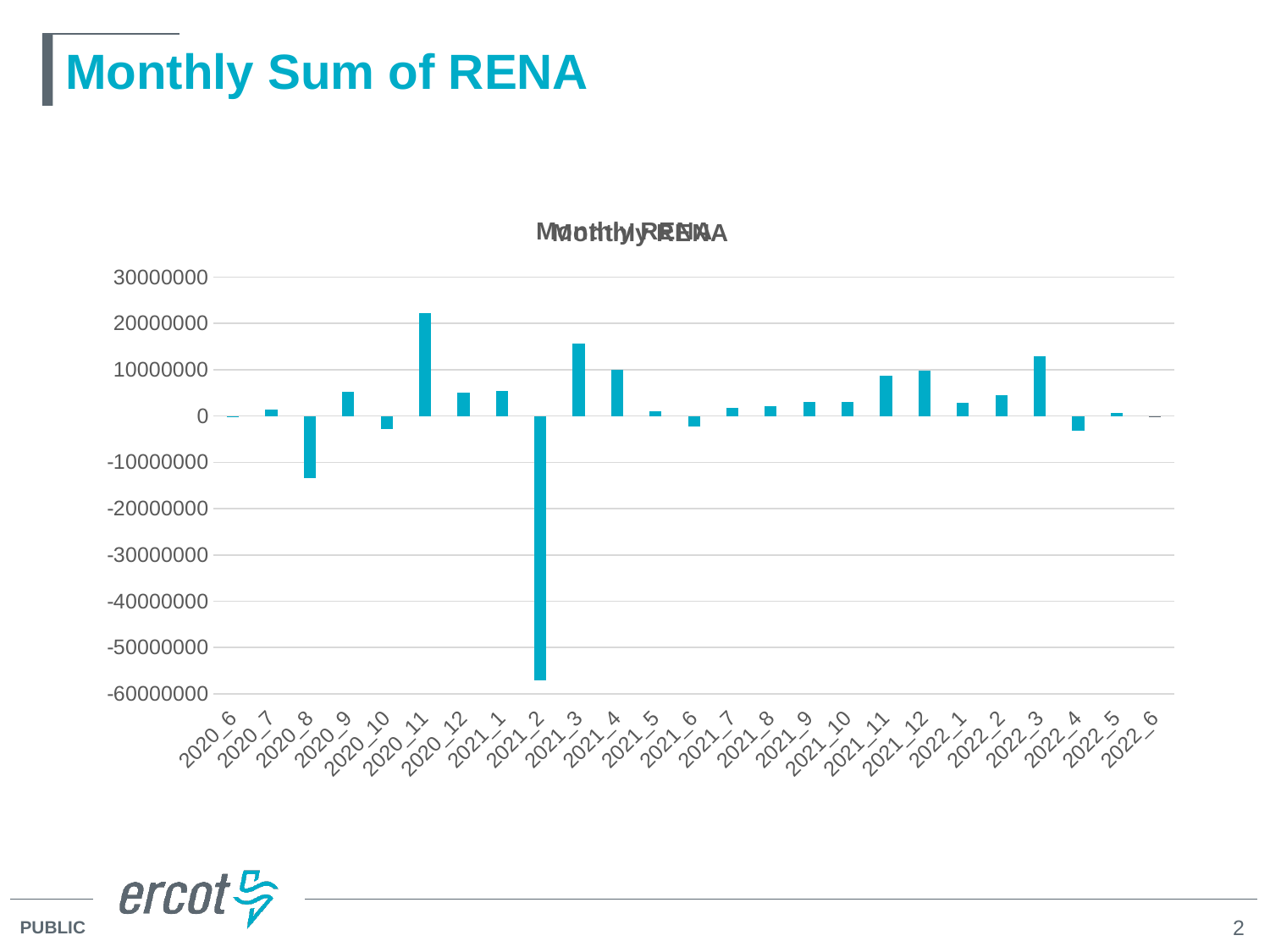
Which month has the lowest value? 2021_2 What kind of chart is shown on the slide? bar chart Is the value for 2021_2 greater or less than -50000000? less Is the value for 2020_8 greater or less than -10000000? less Is the value for 2022_3 greater or less than 10000000? greater Which is larger, the value for 2020_11 or the value for 2021_3? 2020_11 How many months are plotted along the x axis? 25 Which is larger, the value for 2021_4 or the value for 2021_5? 2021_4 Which month has the highest value? 2020_11 What colour are the bars in the chart? teal blue